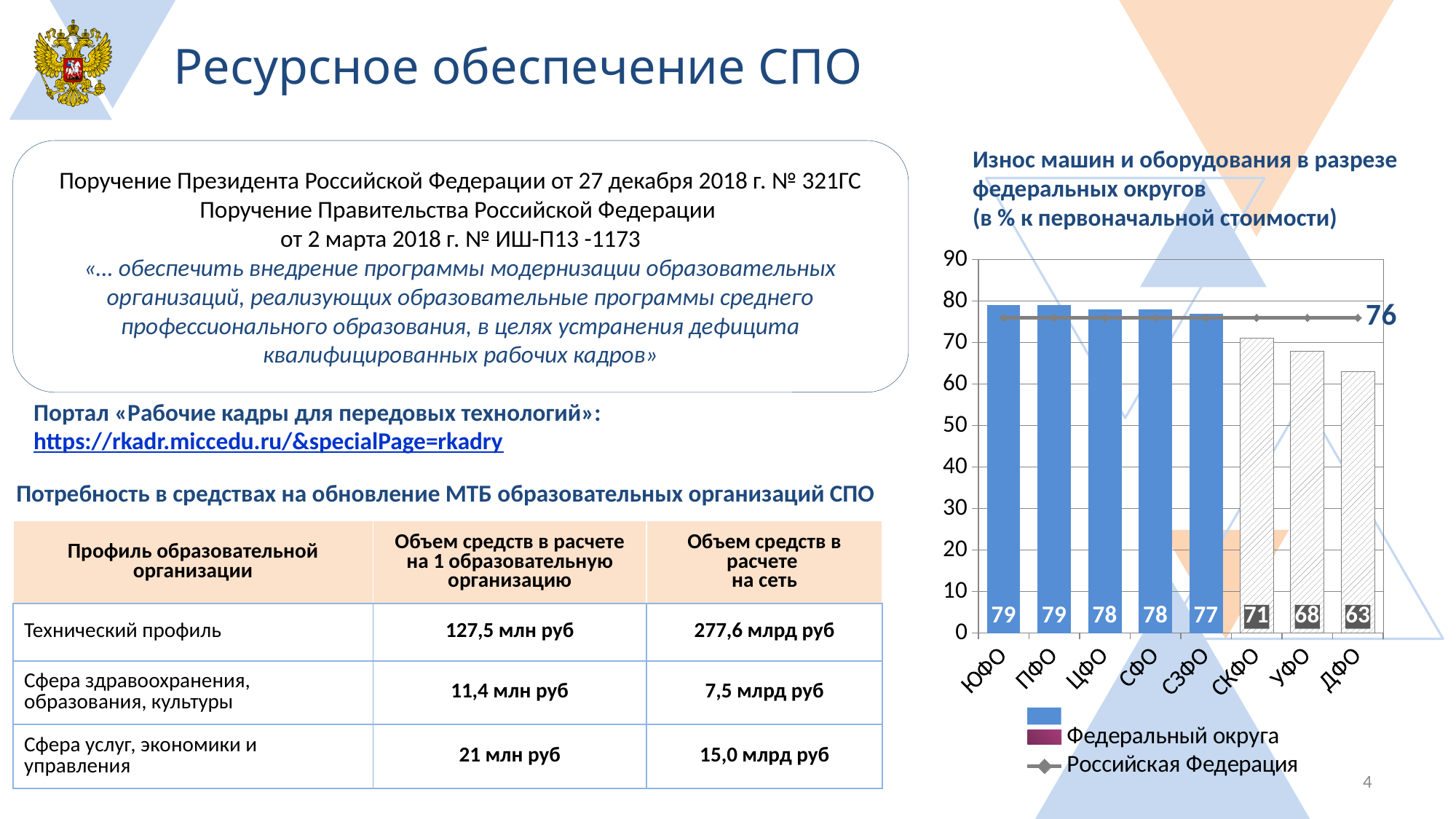
What is the value for ЮФО? 79 What is the difference between the values for ЮФО and ДФО? 16 Which federal district has the lowest value? ДФО How many federal districts are shown on the x axis? 8 Do the bar values rise or fall from ЮФО to ДФО along the x axis? fall What is the value for ДФО? 63 Is the value for ДФО greater or less than 70? less What is the value for СКФО? 71 Which is larger, the value for СКФО or the value for УФО? СКФО What kind of chart is this? combination bar and line chart What is the title of the chart? Износ машин и оборудования в разрезе федеральных округов (в % к первоначальной стоимости) What is the value shown for the Российская Федерация line? 76